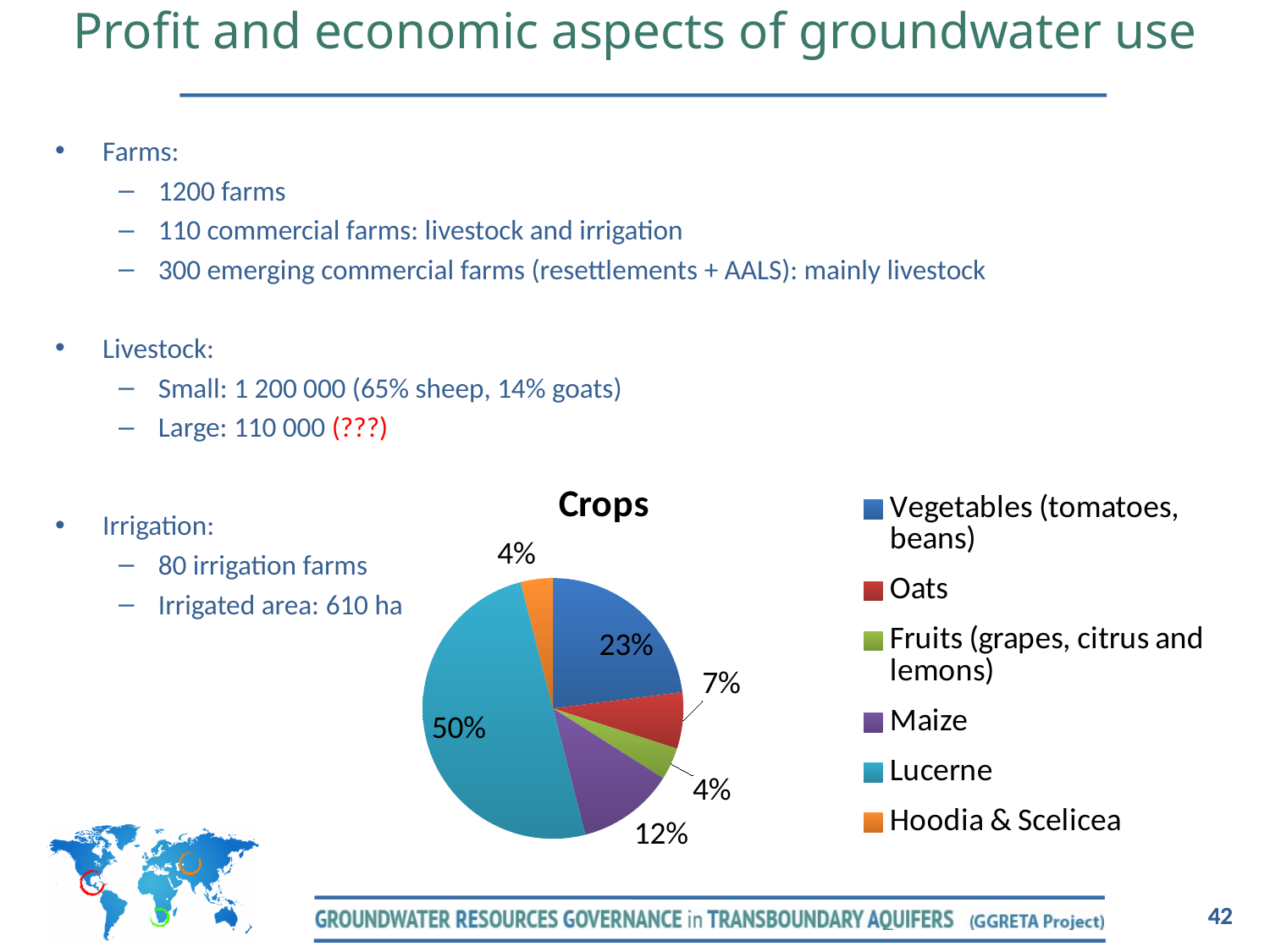
What share of the Crops pie chart is Maize? 12% What kind of chart is the Crops chart? Pie chart What share of the Crops pie chart is Oats? 7% What share of the Crops pie chart is Lucerne? 50% In the Crops pie chart, which is larger: the share for Maize or the share for Oats? Maize In the Crops pie chart, what is the difference between the Lucerne share and the Vegetables (tomatoes, beans) share? 27% In the Crops pie chart, which colour represents Lucerne? Teal (light blue) What is the title of the pie chart on the slide? Crops Which crop has the largest share in the Crops pie chart? Lucerne What share of the Crops pie chart is Vegetables (tomatoes, beans)? 23% In the Crops pie chart, what is the combined share of Vegetables (tomatoes, beans) and Maize? 35% How many crop categories does the legend of the Crops pie chart list? 6